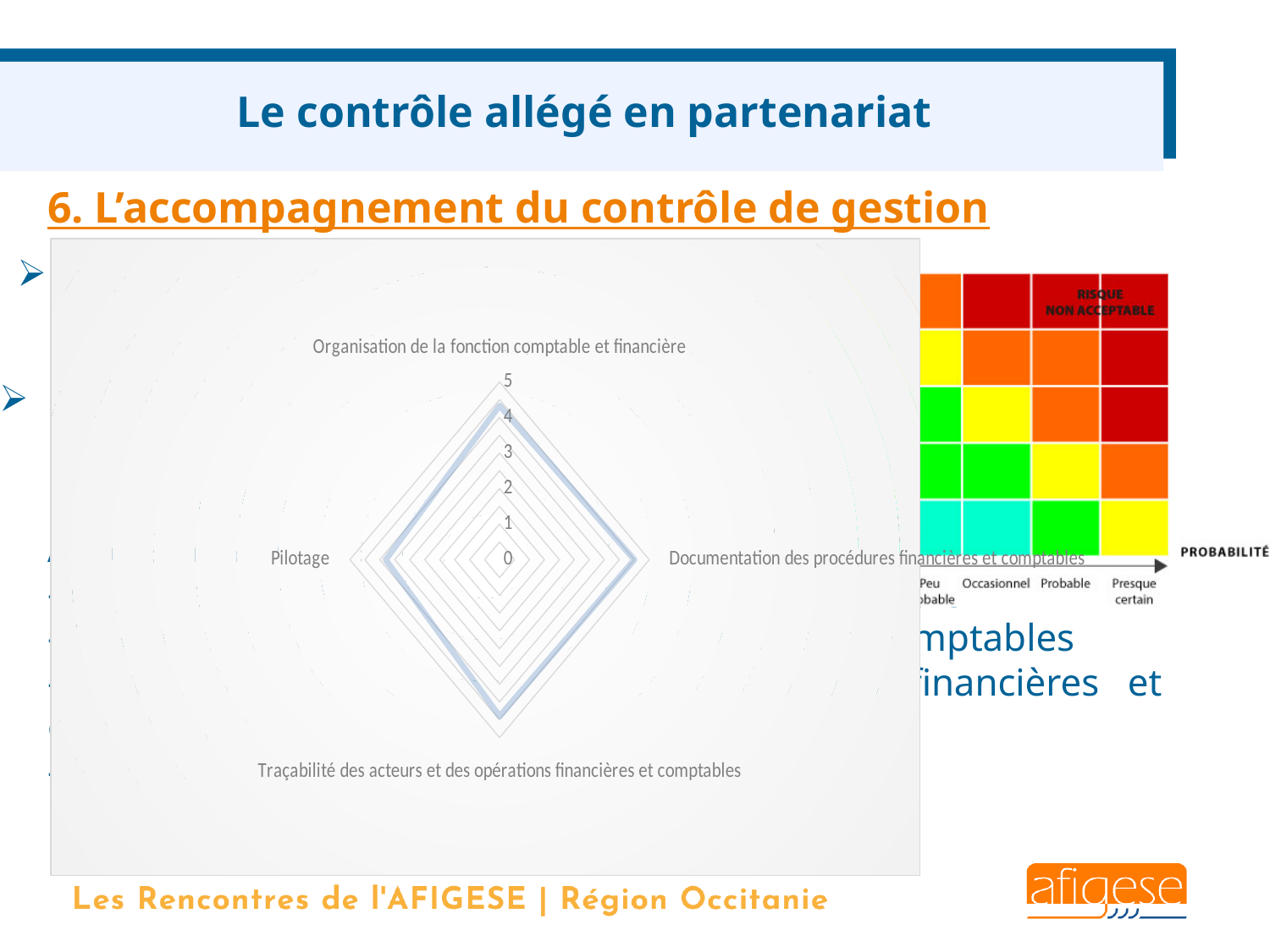
Is the value for 'Documentation des procédures financières et comptables' on the radar chart greater or less than 5? less What is the maximum value shown on the radar chart's scale? 5 What kind of chart is shown on the slide? Radar chart How many categories (axes) does the radar chart have? 4 Is the value for 'Organisation de la fonction comptable et financière' on the radar chart greater or less than 5? less Is the value for 'Traçabilité des acteurs et des opérations financières et comptables' on the radar chart greater or less than 2? greater Which category label appears at the bottom of the radar chart? Traçabilité des acteurs et des opérations financières et comptables